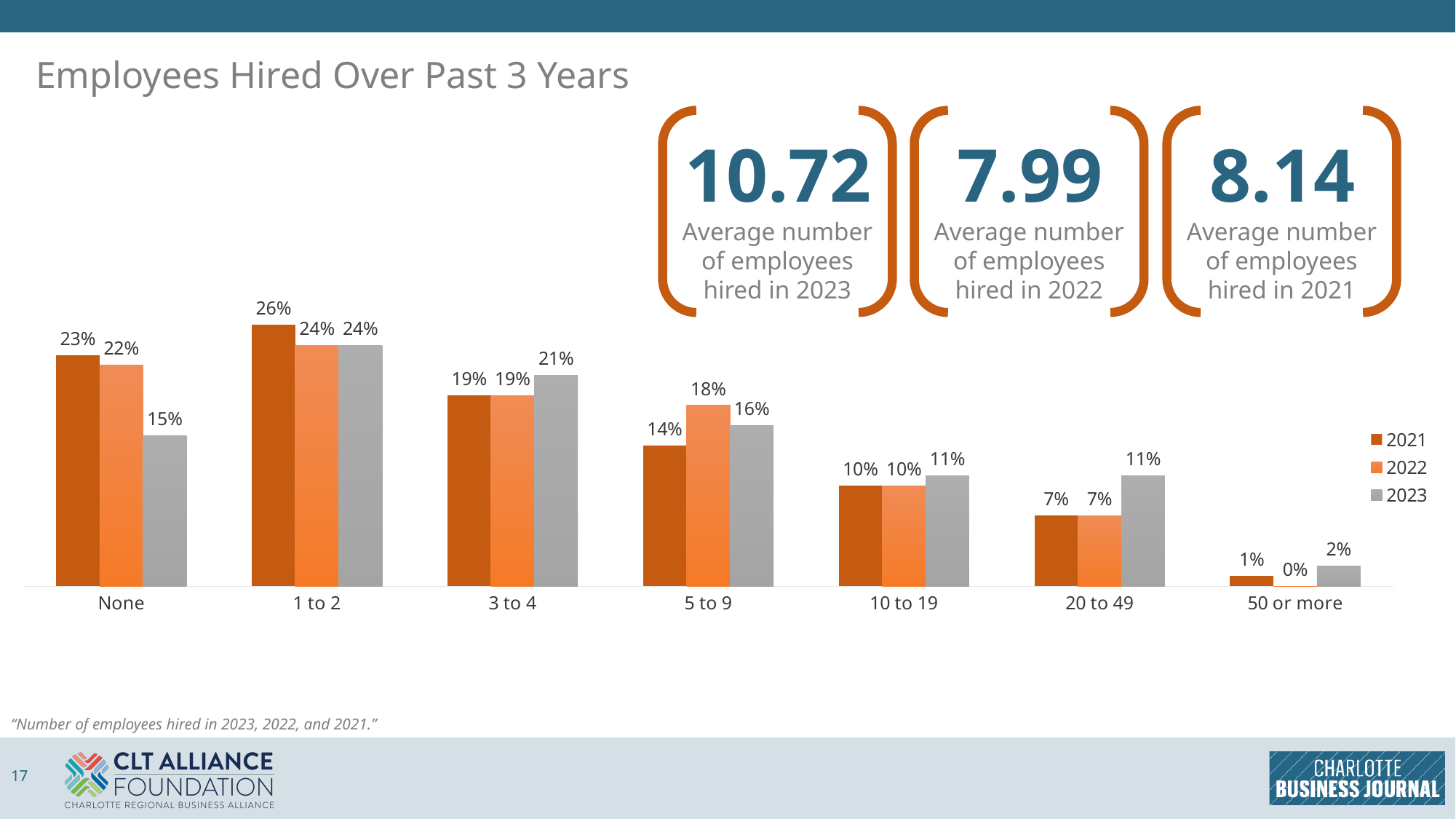
Which category has the lowest value for the 2023 series? 50 or more What is the value for the 'None' category in 2023? 15% What percentage of respondents hired 1 to 2 employees in 2021? 26% Which is larger for the 3 to 4 category: the 2022 value or the 2023 value? 2023 Which category has the highest value for the 2021 series? 1 to 2 How many series does the legend list? 3 How many categories are shown on the x axis? 7 What is the title of the chart? Employees Hired Over Past 3 Years What percentage hired 5 to 9 employees in 2022? 18% What is the average number of employees hired in 2023 shown on the slide? 10.72 What kind of chart is shown on the slide? Bar chart What is the difference between the 2021 and 2023 values for the 'None' category? 8%